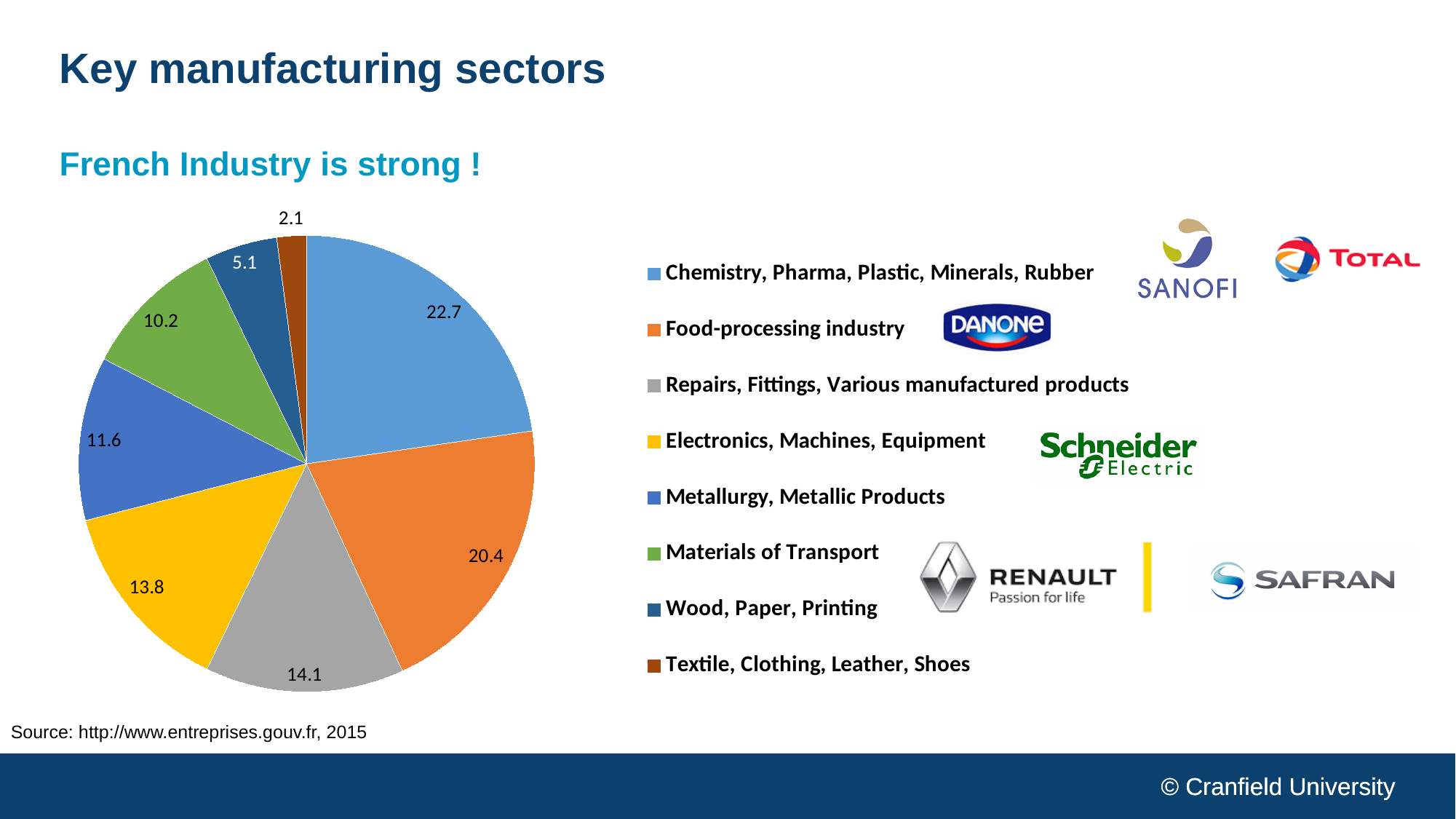
What is the value for Chemistry, Pharma, Plastic, Minerals, Rubber? 22.7 What is the value for Wood, Paper, Printing? 5.1 Which sector has the smallest slice of the pie? Textile, Clothing, Leather, Shoes What is the value for Food-processing industry? 20.4 How many slices does the pie chart have? 8 Which colour represents Metallurgy, Metallic Products in the legend? Blue What is the value for Materials of Transport? 10.2 What is the difference between the values for Chemistry, Pharma, Plastic, Minerals, Rubber and Food-processing industry? 2.3 Which sector has the largest slice of the pie? Chemistry, Pharma, Plastic, Minerals, Rubber What is the difference between the values for Repairs, Fittings, Various manufactured products and Textile, Clothing, Leather, Shoes? 12.0 Which is larger: Electronics, Machines, Equipment or Metallurgy, Metallic Products? Electronics, Machines, Equipment What kind of chart is shown on the slide? Pie chart